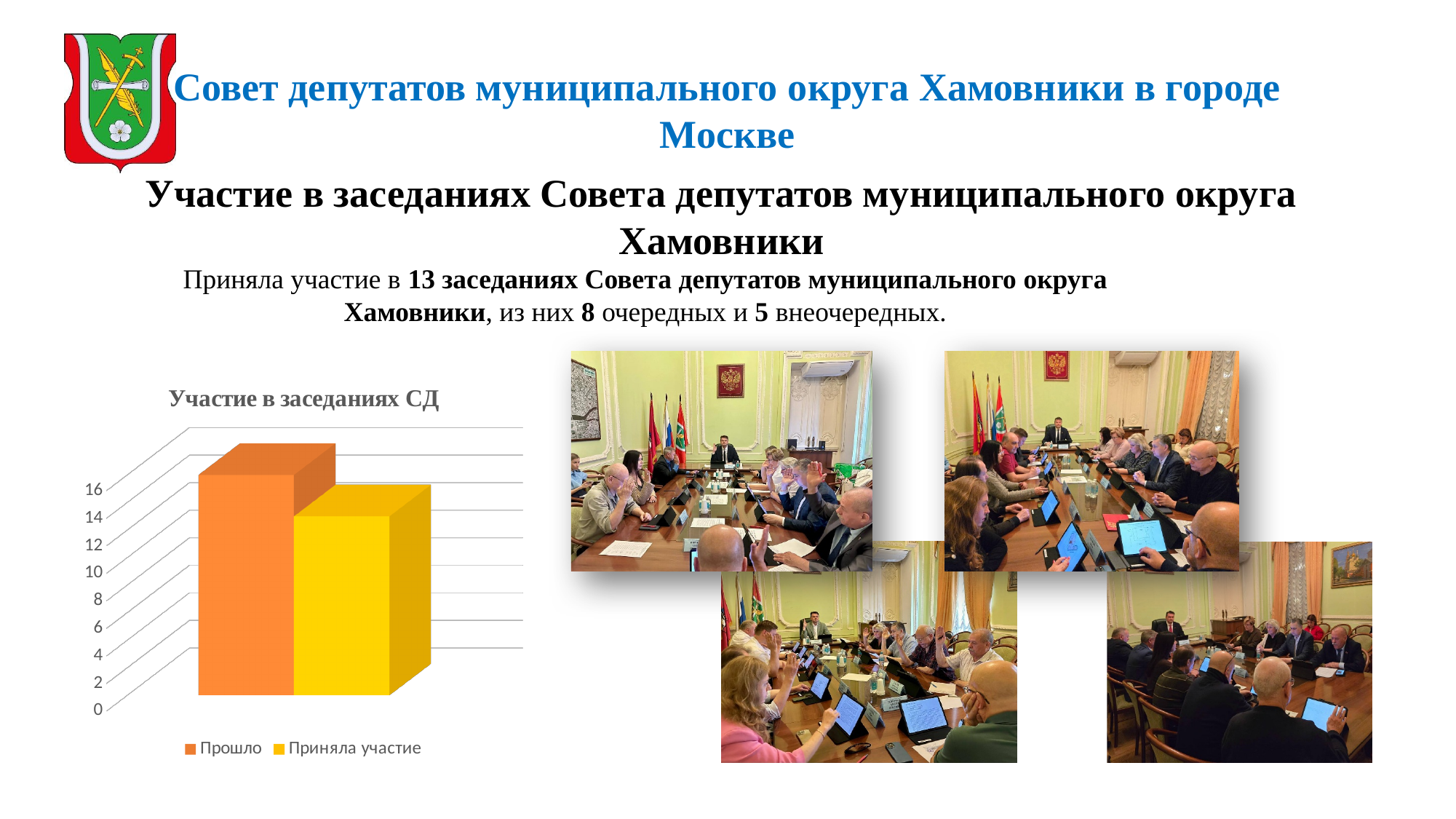
Which series has the tallest bar in the chart? Прошло What is the title of the chart on the slide? Участие в заседаниях СД How many series does the chart legend list? 2 Which series has the shortest bar in the chart? Приняла участие What is the highest value shown on the vertical axis of the chart? 16 Is the value for Прошло greater or less than 12? greater What kind of chart is shown on the slide? bar chart Is the value for Приняла участие greater or less than 8? greater Is the value for Приняла участие greater or less than 16? less Which series has the taller bar in the chart, Прошло or Приняла участие? Прошло Which series is shown in orange in the chart? Прошло